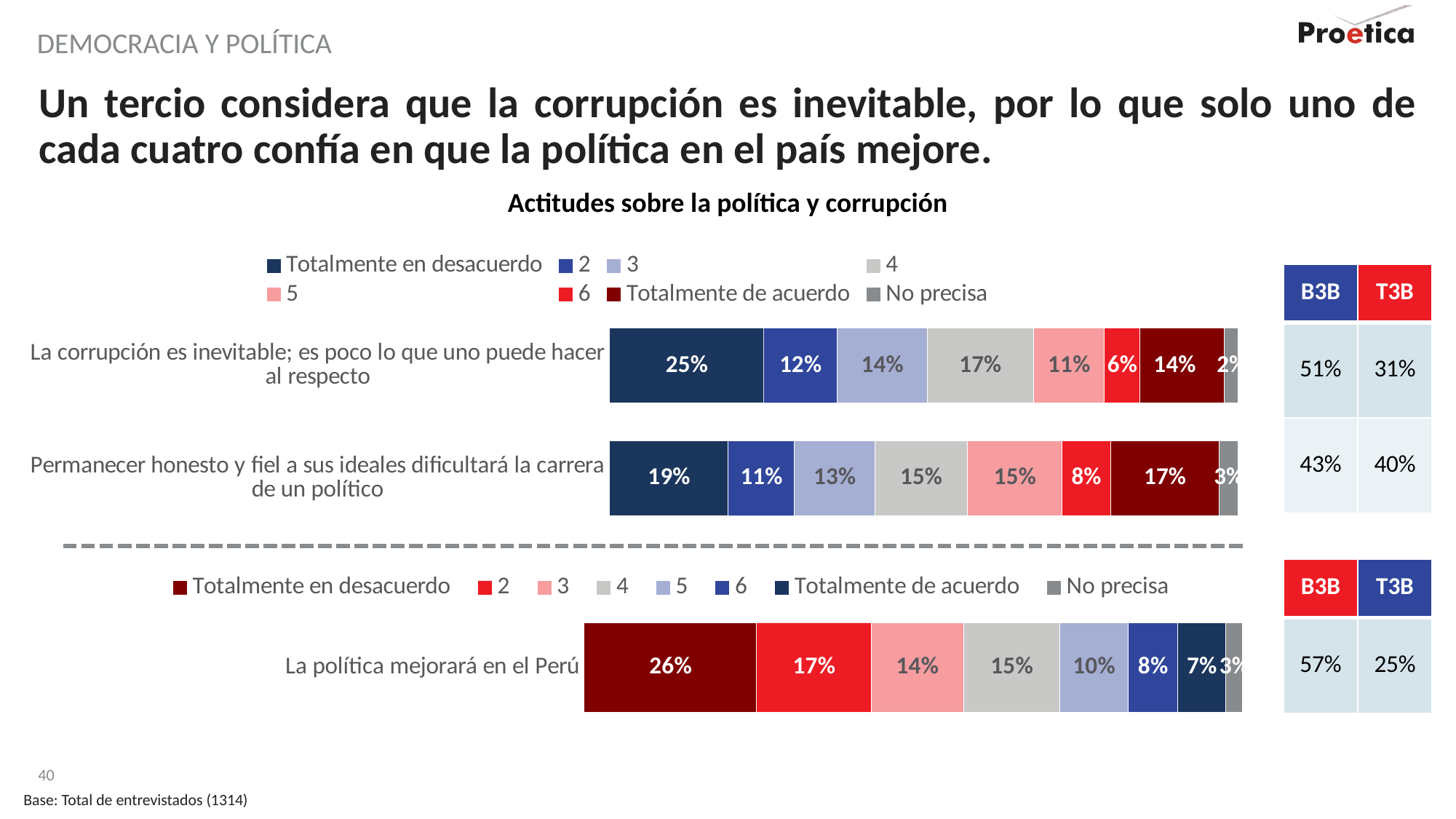
In the lower chart, which response category has the smallest share for 'La política mejorará en el Perú'? No precisa In the lower chart, what is the 'No precisa' value for 'La política mejorará en el Perú'? 3% In the upper chart, what is the difference between the 'Totalmente en desacuerdo' values of the two statements? 6% How many series does the legend of the lower chart list? 8 In the upper chart, which statement has the larger '6' value? Permanecer honesto y fiel a sus ideales dificultará la carrera de un político In the upper chart, which response category has the largest share for 'La corrupción es inevitable; es poco lo que uno puede hacer al respecto'? Totalmente en desacuerdo In the upper chart, what is the 'Totalmente de acuerdo' value for 'Permanecer honesto y fiel a sus ideales dificultará la carrera de un político'? 17% What is the title of the chart on the slide? Actitudes sobre la política y corrupción In the upper chart, what is the 'Totalmente en desacuerdo' value for 'La corrupción es inevitable; es poco lo que uno puede hacer al respecto'? 25% In the lower chart, what is the 'Totalmente en desacuerdo' value for 'La política mejorará en el Perú'? 26% How many statements (bars) are plotted in the upper chart? 2 What type of chart is used on this slide? Stacked bar chart